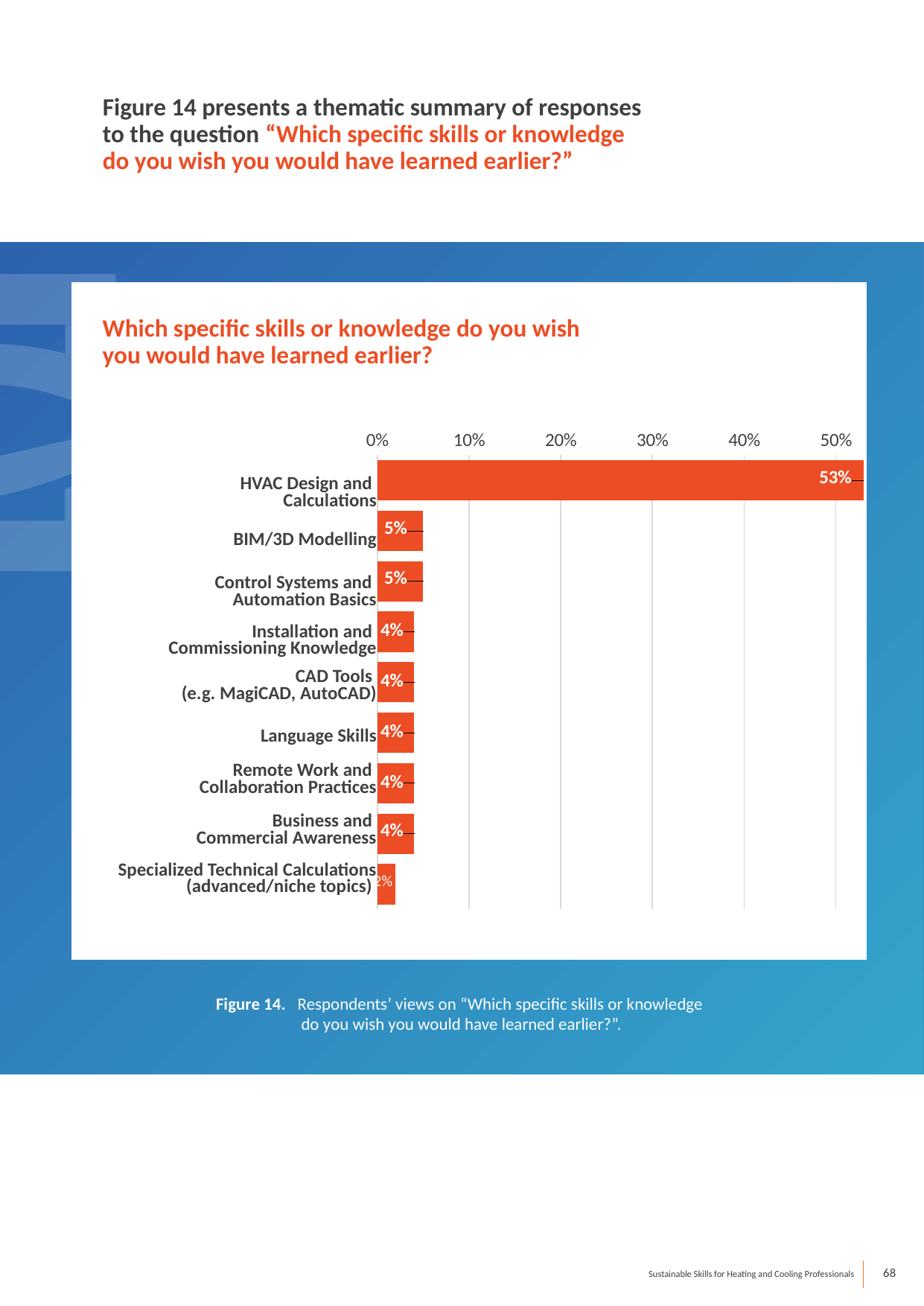
How many categories are shown in the chart? 9 What is the difference between the values for HVAC Design and Calculations and Control Systems and Automation Basics? 48% What is the value for HVAC Design and Calculations? 53% What is the value for Language Skills? 4% Which category has the lowest value? Specialized Technical Calculations (advanced/niche topics) What is the value for Specialized Technical Calculations (advanced/niche topics)? 2% What kind of chart is shown? bar chart What is the value for BIM/3D Modelling? 5% What is the title of the chart? Which specific skills or knowledge do you wish you would have learned earlier? Is the value for HVAC Design and Calculations greater or less than 50%? greater Which category has the highest value? HVAC Design and Calculations Which is larger, the value for BIM/3D Modelling or the value for Business and Commercial Awareness? BIM/3D Modelling